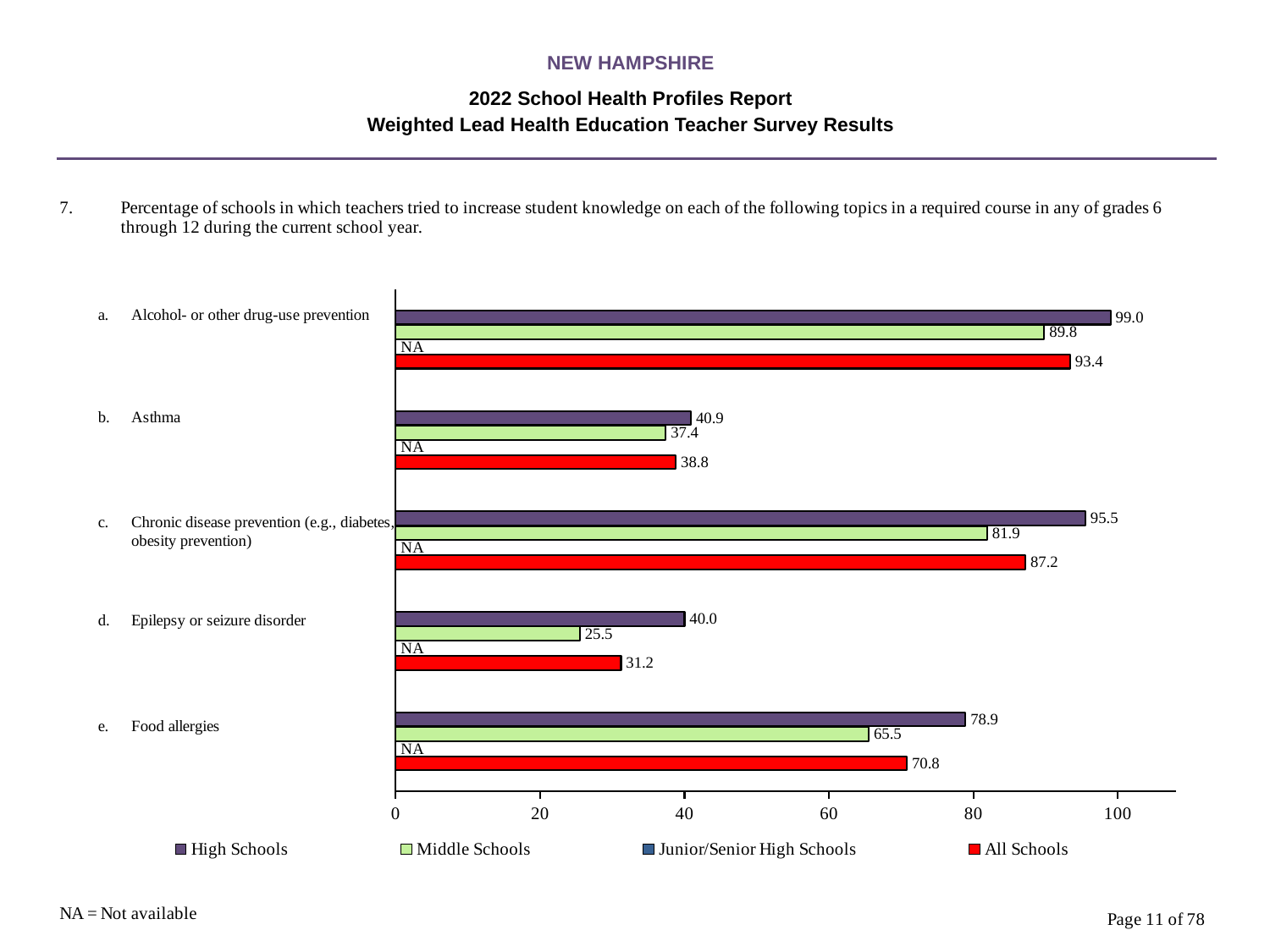
What is the All Schools value for Epilepsy or seizure disorder? 31.2 Which is larger for Food allergies: the High Schools value or the All Schools value? High Schools What is the Middle Schools value for Asthma? 37.4 What is the High Schools value for Alcohol- or other drug-use prevention? 99.0 How many topics are listed on the chart? 5 What kind of chart is shown? Bar chart Which topic has the highest All Schools value? Alcohol- or other drug-use prevention What value is shown for Junior/Senior High Schools for Asthma? NA What is the difference between the High Schools and Middle Schools values for Chronic disease prevention? 13.6 Which topic has the lowest Middle Schools value? Epilepsy or seizure disorder What is the Middle Schools value for Food allergies? 65.5 How many series does the legend list? 4